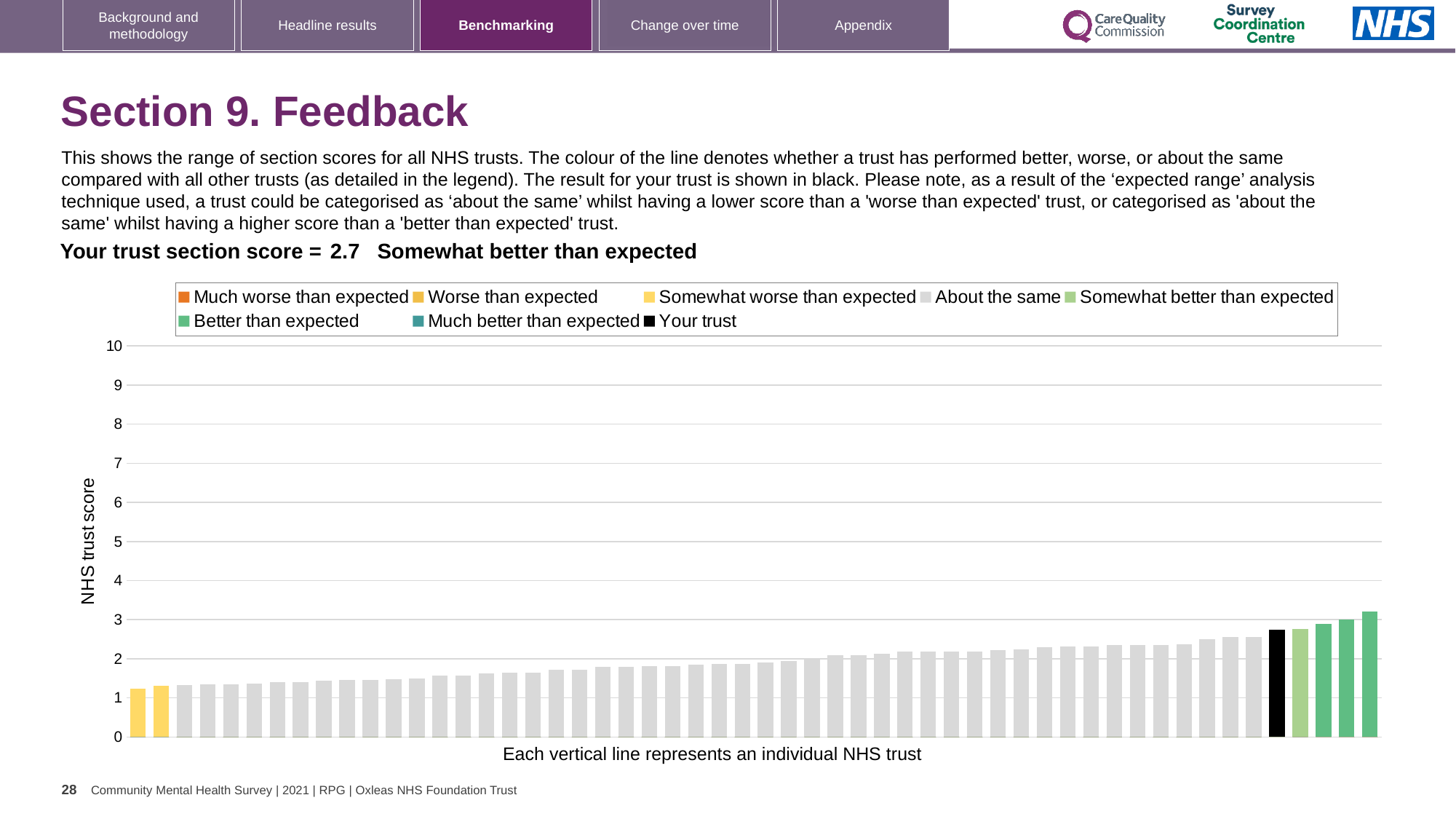
Which benchmarking category is your trust's section score placed in? Somewhat better than expected Do the bar values rise or fall from left to right along the x axis? rise Is the value for your trust greater or less than 3? less What kind of chart is shown on the slide? bar chart Is the tallest bar in the chart greater or less than 3? greater What is the section score for your trust? 2.7 How many entries does the chart legend list? 8 Which legend category do the tallest bars belong to? Better than expected Is the shortest bar in the chart greater or less than 2? less Which legend category do the shortest bars belong to? Somewhat worse than expected What is the label on the y axis of the chart? NHS trust score